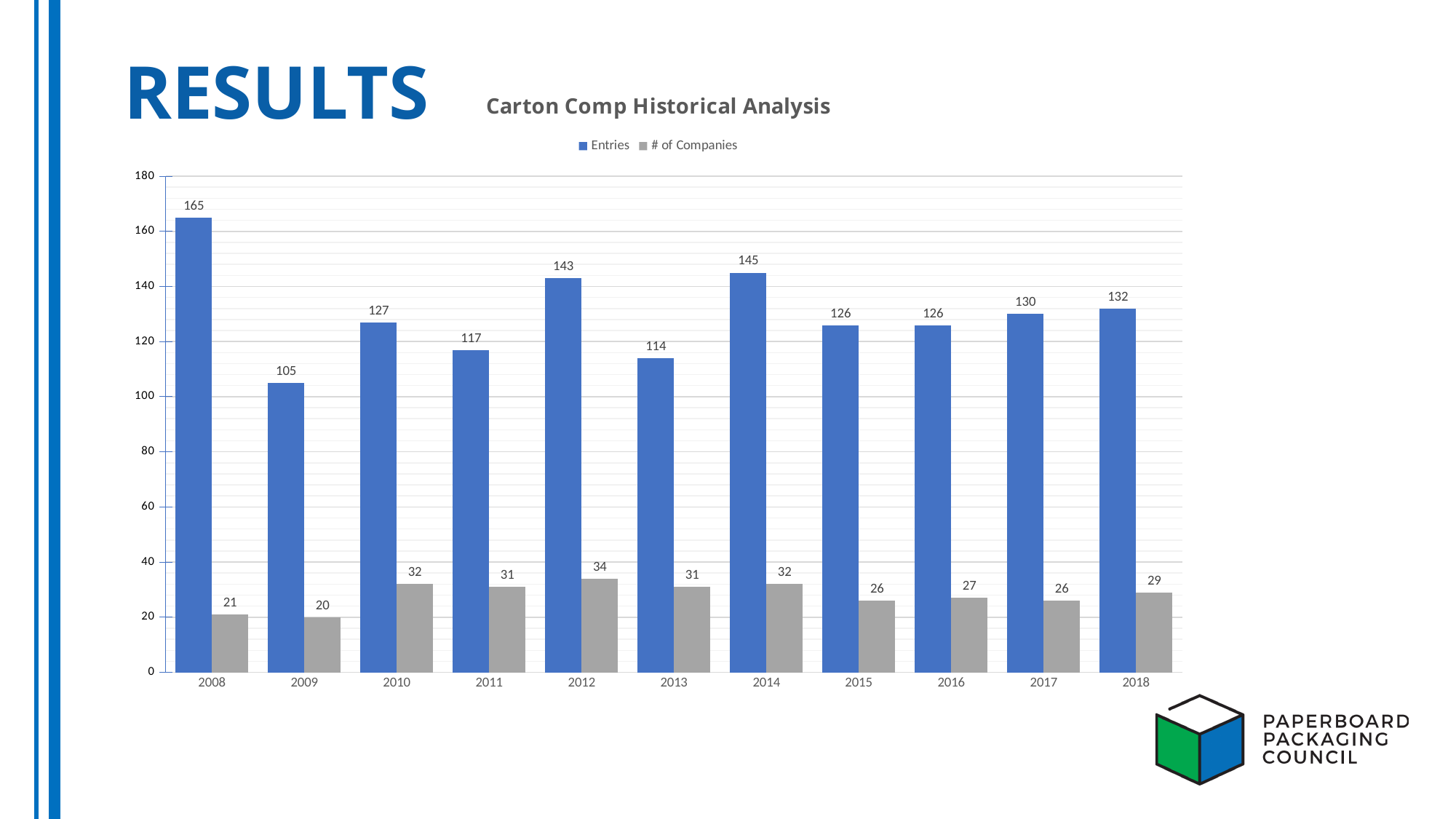
What is the # of Companies in 2012? 34 What is the difference between Entries in 2014 and Entries in 2013? 31 What is the title of the chart? Carton Comp Historical Analysis Which colour represents the Entries series? Blue How many years are shown on the x axis? 11 How many series does the legend list? 2 Which year has the highest # of Companies? 2012 What is the difference between the # of Companies in 2010 and in 2009? 12 What is the number of Entries in 2008? 165 Which year has the lowest number of Entries? 2009 What kind of chart is shown on the slide? Bar chart Which is larger: Entries in 2010 or Entries in 2011? Entries in 2010